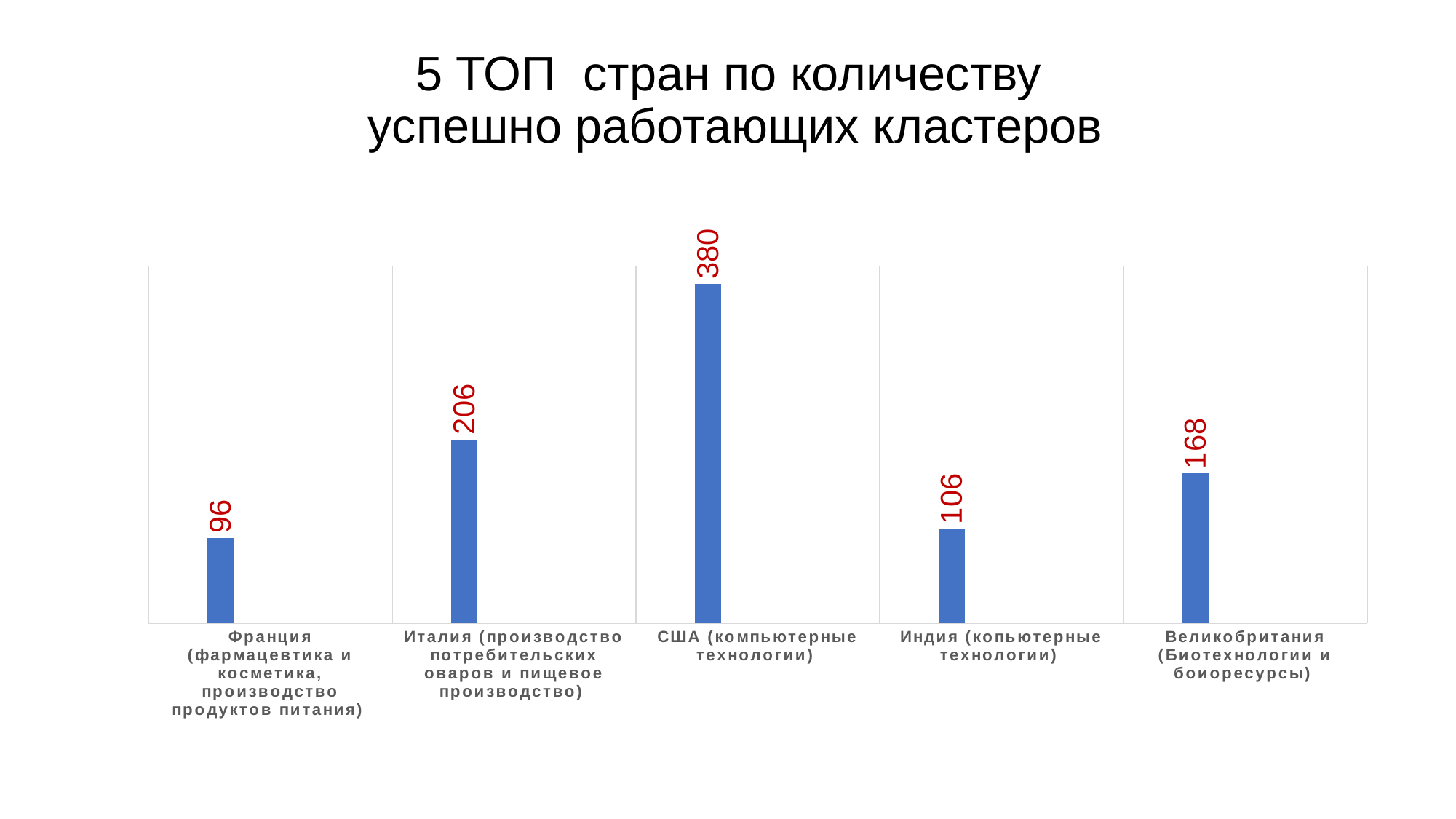
What kind of chart is shown on the slide? Bar chart What is the value for Италия (производство потребительских оваров и пищевое производство)? 206 Which country has the highest number of successfully operating clusters? США (компьютерные технологии) What is the value for Великобритания (Биотехнологии и боиоресурсы)? 168 What is the value for Индия (копьютерные технологии)? 106 Which is larger, the value for Великобритания or the value for Индия? Великобритания What is the value for США (компьютерные технологии)? 380 How many countries are shown in the chart? 5 What is the value for Франция (фармацевтика и косметика, производство продуктов питания)? 96 What is the difference between the values for США and Италия? 174 What is the title of the slide? 5 ТОП стран по количеству успешно работающих кластеров Which country has the lowest number of successfully operating clusters? Франция (фармацевтика и косметика, производство продуктов питания)